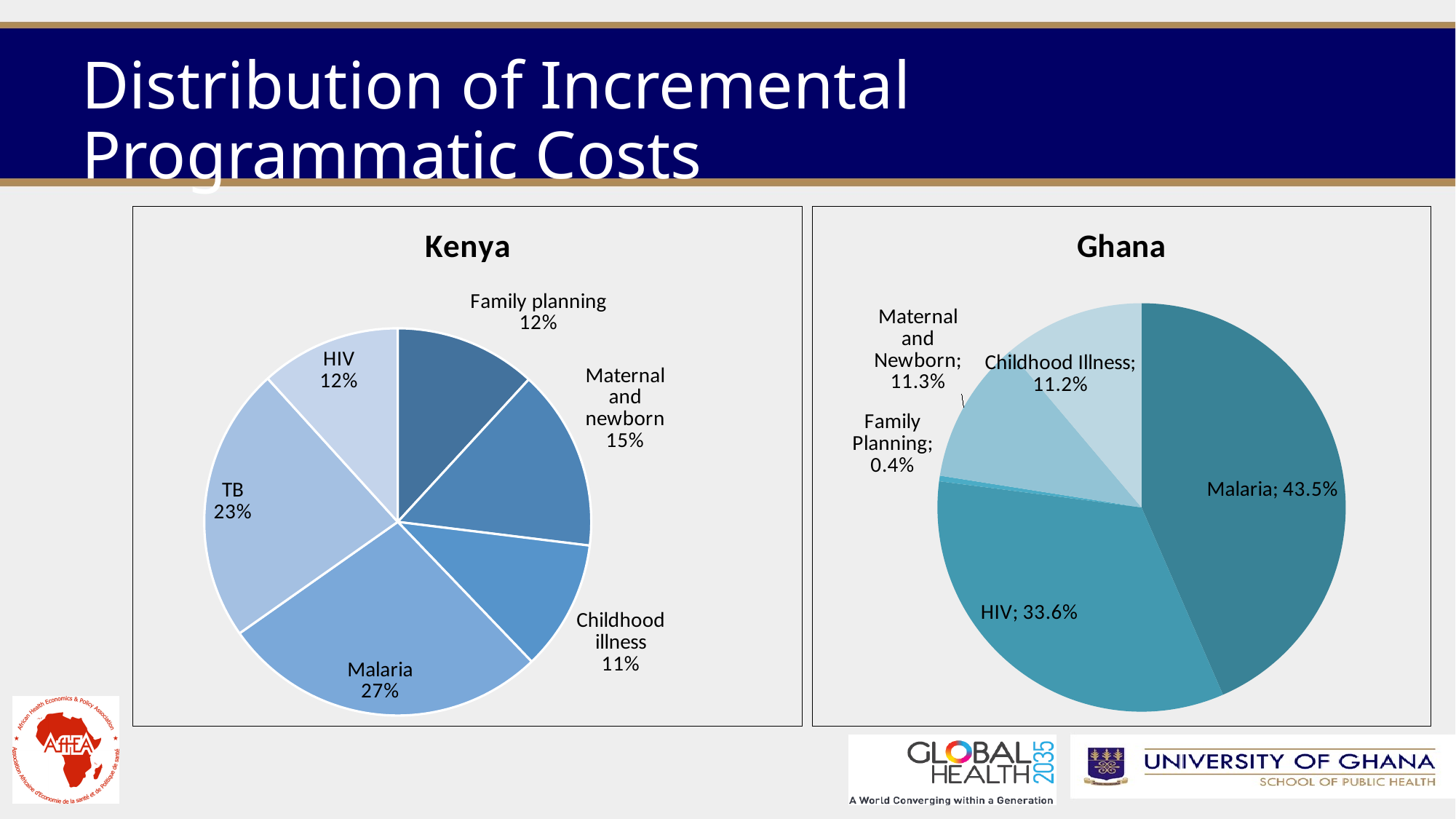
In the Ghana chart, which category has the smallest share? Family Planning In the Ghana chart, which is larger: Maternal and Newborn or Childhood Illness? Maternal and Newborn In the Ghana chart, what is the difference between the Malaria and HIV shares? 9.9% How many categories are shown in the Kenya chart? 6 In the Ghana chart, what is the value for Family Planning? 0.4% In the Ghana chart, what is the value for HIV? 33.6% In the Kenya chart, what is the value for TB? 23% In the Kenya chart, which category has the largest share? Malaria In the Kenya chart, what is the difference between the Malaria and TB shares? 4% In the Ghana chart, which category has the largest share? Malaria In the Kenya chart, what share of incremental programmatic costs goes to Malaria? 27% In the Kenya chart, which category has the smallest share? Childhood illness